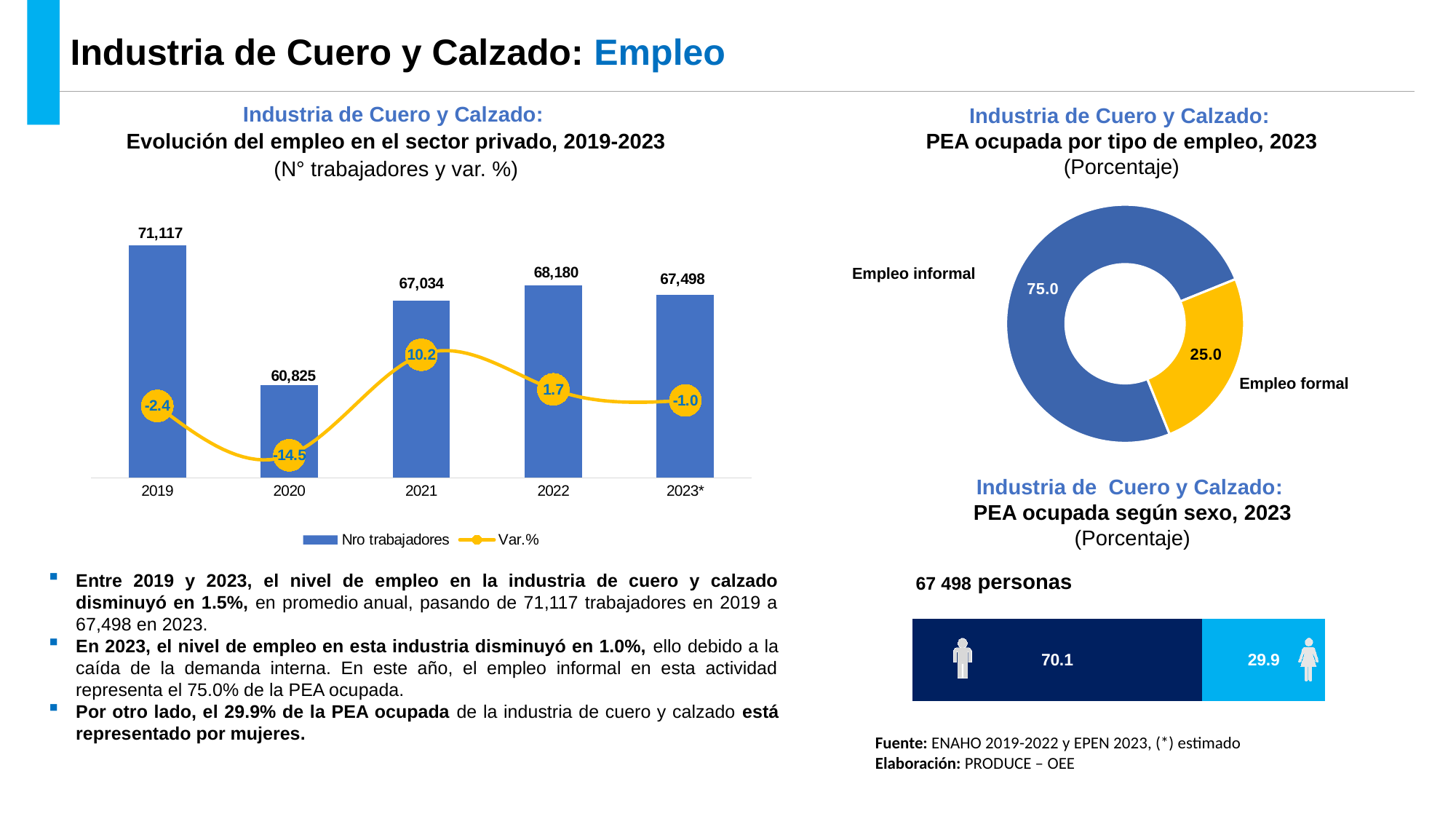
In the chart 'Evolución del empleo en el sector privado, 2019-2023', how many years are shown on the x axis? 5 In the chart 'Evolución del empleo en el sector privado, 2019-2023', how many series does the legend list? 2 In the chart 'Evolución del empleo en el sector privado, 2019-2023', which year has the lowest number of workers? 2020 What kind of chart is 'PEA ocupada por tipo de empleo, 2023'? Doughnut chart In the chart 'PEA ocupada según sexo, 2023', what is the percentage for men? 70.1 In the chart 'Evolución del empleo en el sector privado, 2019-2023', which year has a larger number of workers, 2021 or 2022? 2022 In the chart 'Evolución del empleo en el sector privado, 2019-2023', which year has the highest Var.% value? 2021 In the chart 'Evolución del empleo en el sector privado, 2019-2023', what is the difference in number of workers between 2022 and 2023*? 682 In the chart 'Evolución del empleo en el sector privado, 2019-2023', what is the number of workers (Nro trabajadores) in 2021? 67,034 In the chart 'Evolución del empleo en el sector privado, 2019-2023', what is the Var.% value for 2020? -14.5 In the chart 'PEA ocupada por tipo de empleo, 2023', what share does Empleo formal represent? 25.0 In the chart 'Evolución del empleo en el sector privado, 2019-2023', which year has the highest number of workers? 2019